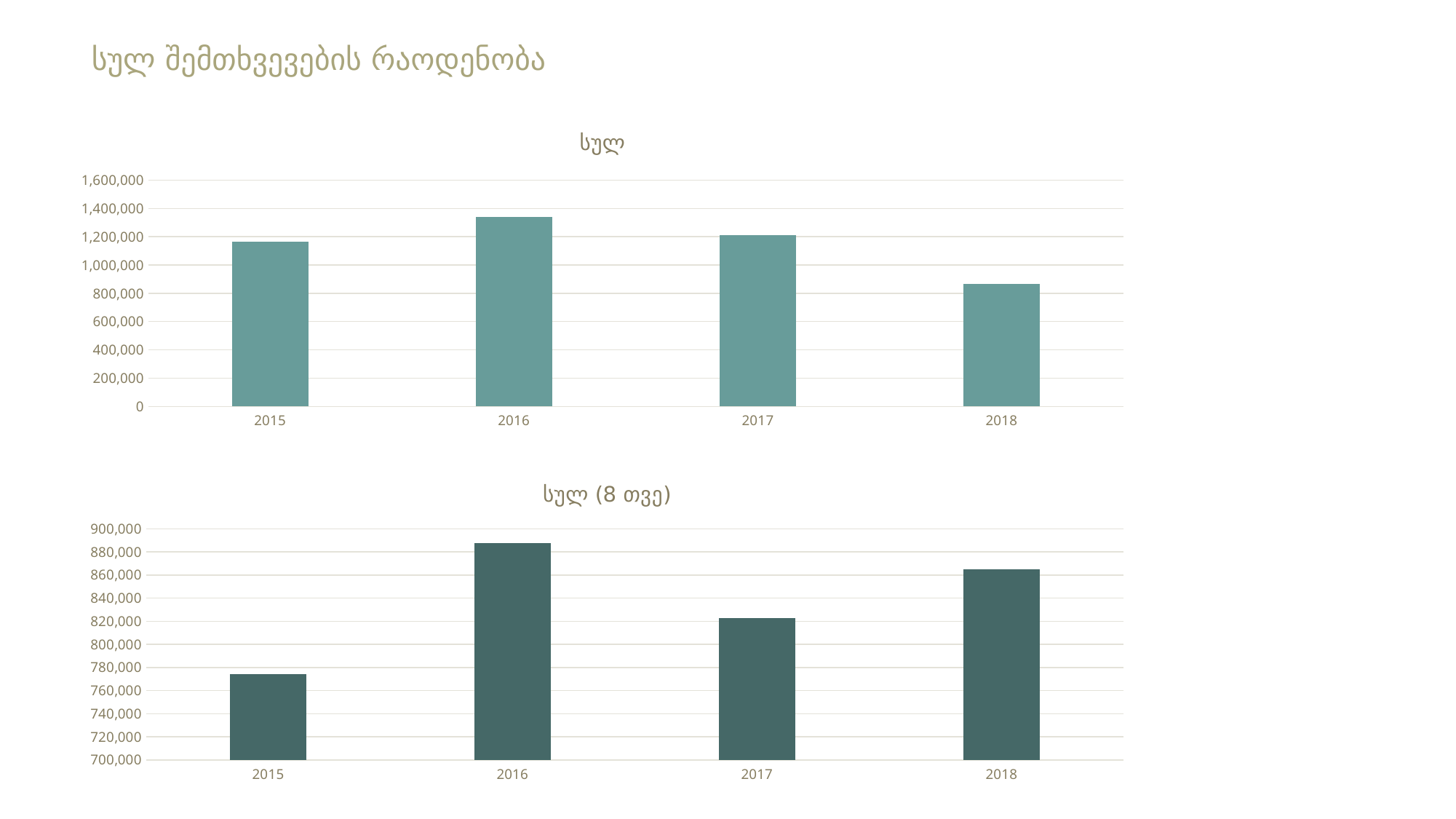
In the bottom chart titled "სულ (8 თვე)", which year has the highest value? 2016 In the top chart titled "სულ", is the value for 2016 greater or less than 1,200,000? greater What is the title of the bottom chart on the slide? სულ (8 თვე) In the top chart titled "სულ", is the value for 2018 greater or less than 1,000,000? less In the bottom chart titled "სულ (8 თვე)", which year has the lowest value? 2015 In the top chart titled "სულ", which year has the highest value? 2016 In the top chart titled "სულ", which year has the lowest value? 2018 What kind of chart is the top chart titled "სულ"? bar chart In the bottom chart titled "სულ (8 თვე)", is the value for 2017 greater or less than 800,000? greater In the top chart titled "სულ", which is larger, the value for 2015 or the value for 2017? 2017 How many years are shown on the x axis of the top chart titled "სულ"? 4 In the bottom chart titled "სულ (8 თვე)", which is larger, the value for 2017 or the value for 2018? 2018